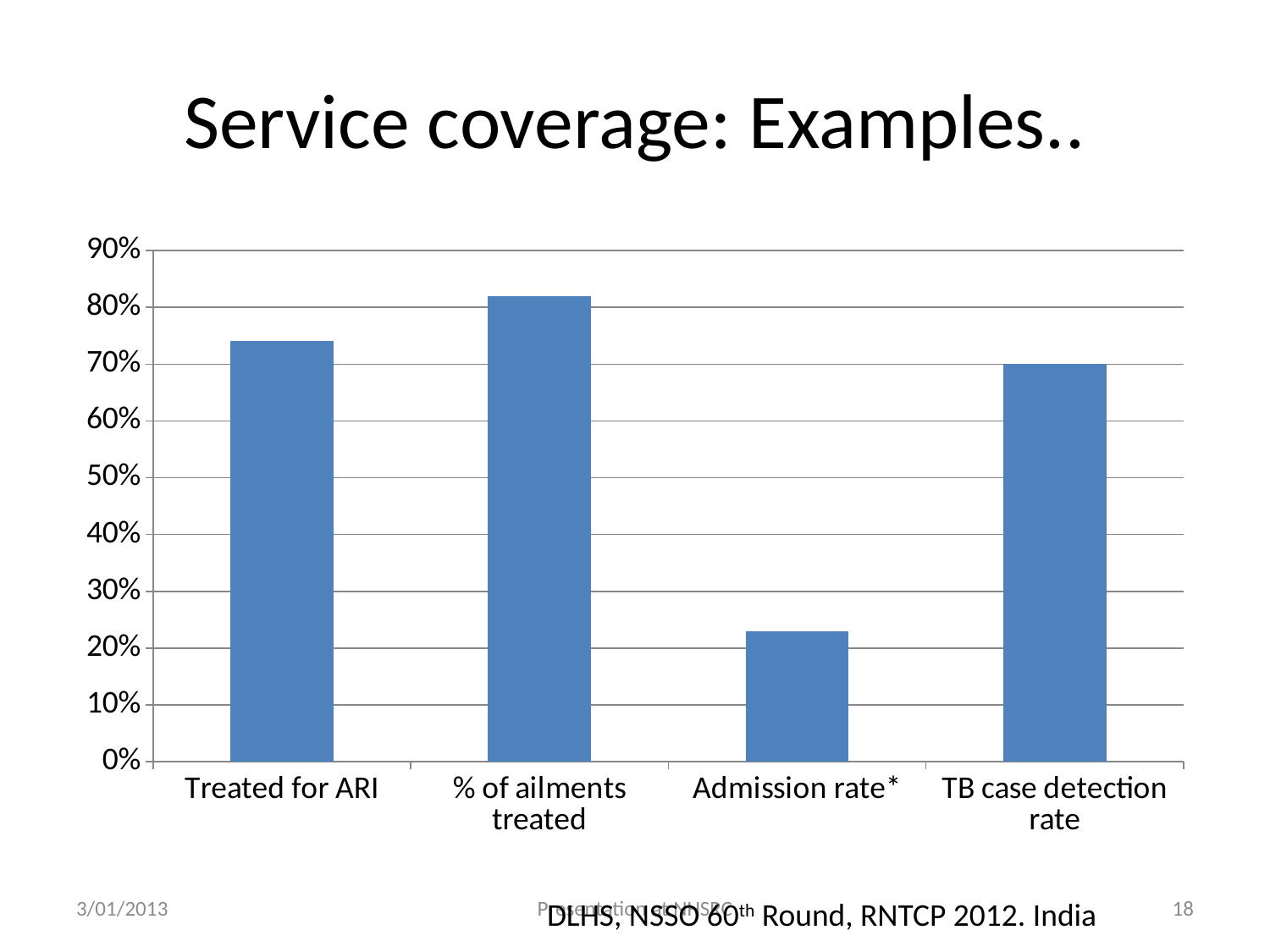
Is the value for Admission rate* greater or less than 30%? less Is the value for % of ailments treated greater or less than 80%? greater Which is larger, the value for Admission rate* or the value for % of ailments treated? % of ailments treated What is the title of the slide containing the chart? Service coverage: Examples.. What is the highest value shown on the y axis? 90% What kind of chart is shown on the slide? Bar chart Is the value for TB case detection rate greater or less than 60%? greater Which category has the lowest value? Admission rate* Which category has the highest value? % of ailments treated Which is larger, the value for Treated for ARI or the value for TB case detection rate? Treated for ARI How many categories are shown on the x axis? 4